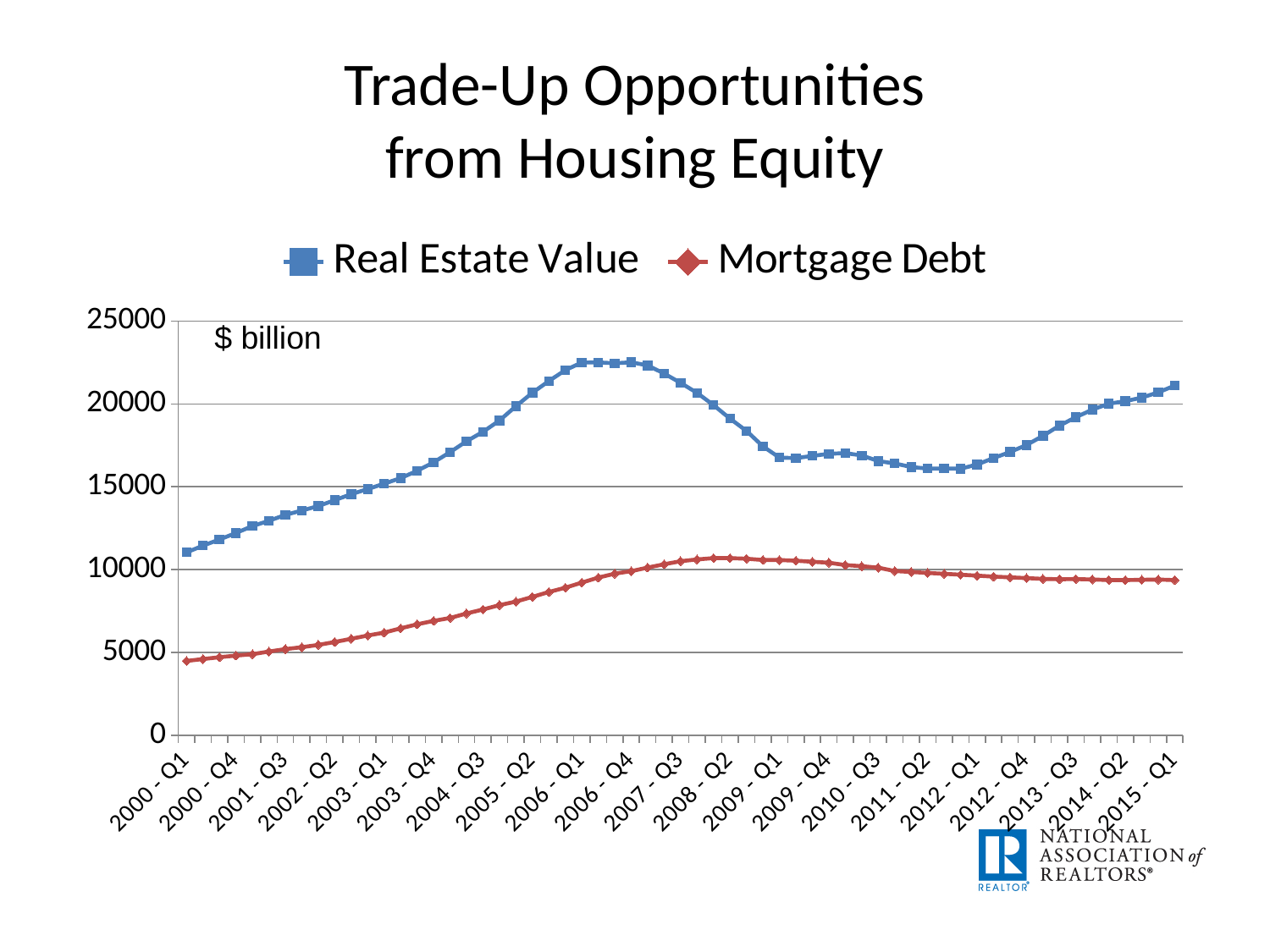
Which series is higher at 2006 - Q4, Real Estate Value or Mortgage Debt? Real Estate Value How many series does the legend list? 2 Is the Mortgage Debt for 2015 - Q1 greater or less than 10000? less What unit is indicated for the values on the chart? $ billion Is the Real Estate Value for 2015 - Q1 greater or less than 20000? greater What kind of chart is shown on the slide? line chart Is the Real Estate Value for 2006 - Q4 greater or less than 20000? greater What is the title of the chart? Trade-Up Opportunities from Housing Equity Does Mortgage Debt rise or fall from 2000 - Q1 to 2008 - Q2? rise Does Real Estate Value rise or fall from 2006 - Q4 to 2009 - Q1? fall